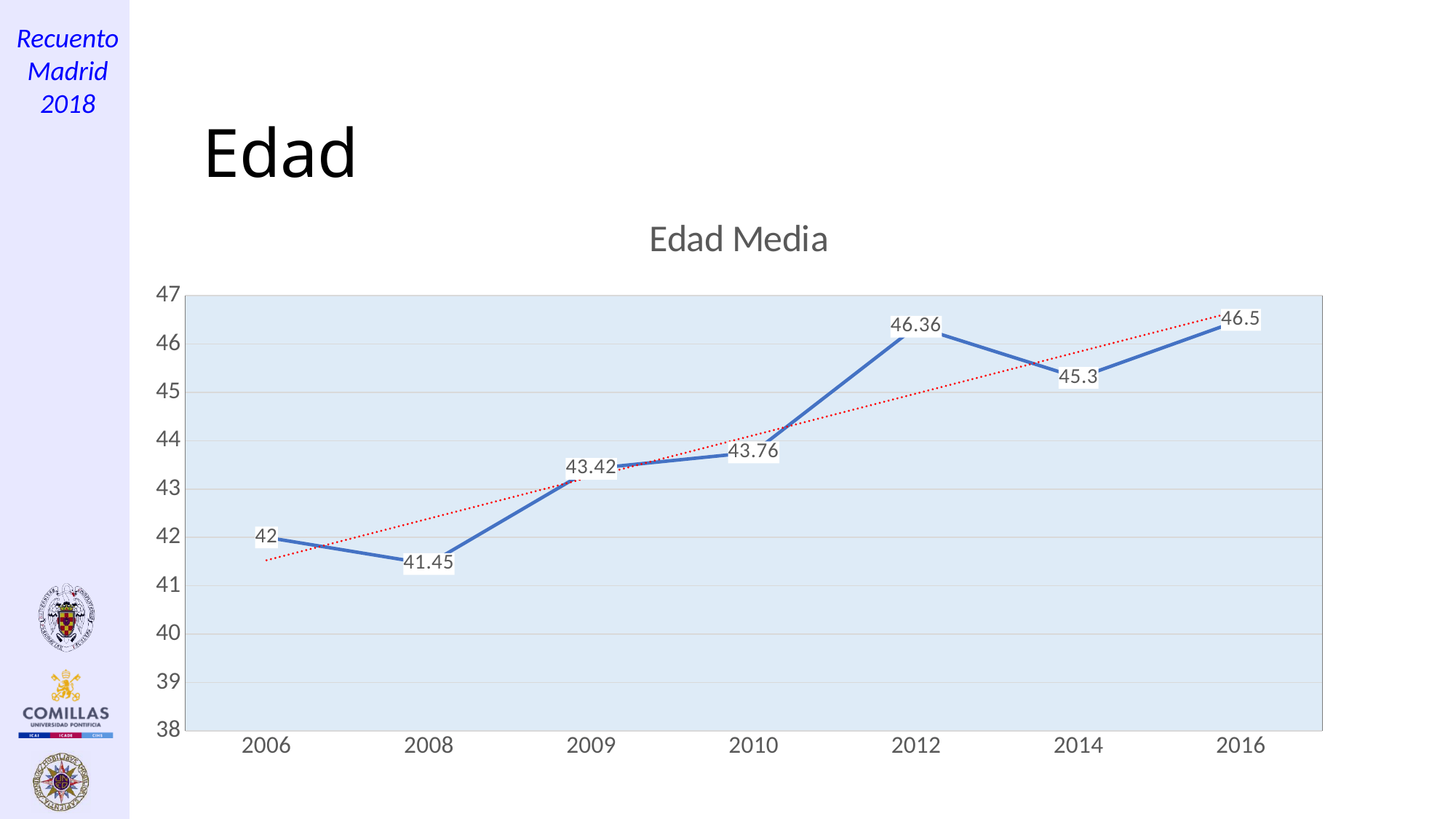
Do the values in the Edad Media chart generally rise or fall from 2006 to 2016? rise Which year has the lowest value in the Edad Media chart? 2008 What is the title of the chart on the slide? Edad Media What is the value for 2006 in the Edad Media chart? 42 What is the value for 2012 in the Edad Media chart? 46.36 Which year has the highest value in the Edad Media chart? 2016 What is the difference between the values for 2016 and 2006 in the Edad Media chart? 4.5 Which is larger in the Edad Media chart, the value for 2009 or the value for 2010? 2010 What kind of chart is the Edad Media chart? line chart What is the value for 2014 in the Edad Media chart? 45.3 How many years are plotted in the Edad Media chart? 7 What is the difference between the values for 2012 and 2014 in the Edad Media chart? 1.06